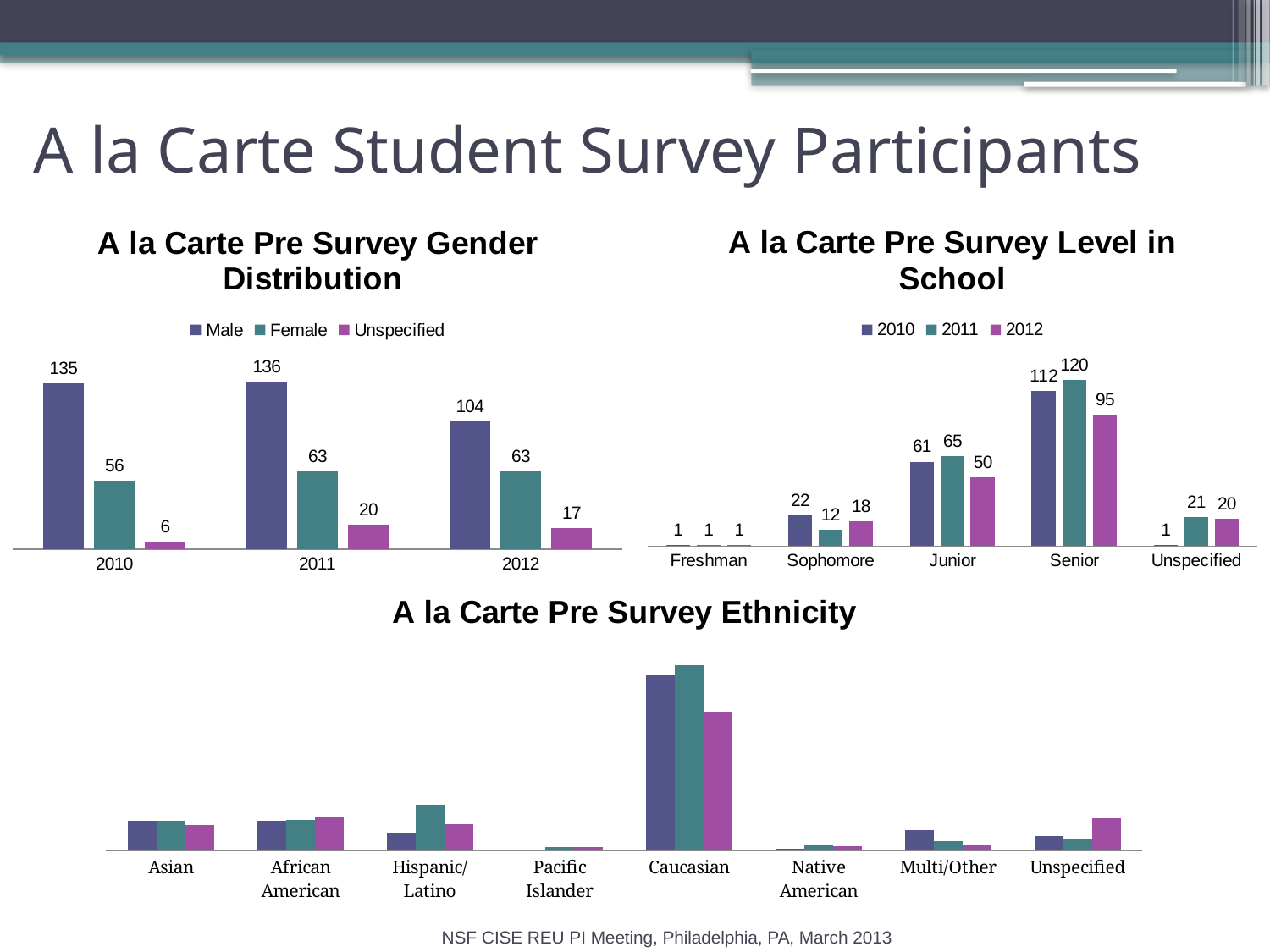
In the A la Carte Pre Survey Gender Distribution chart, what is the Male value for 2010? 135 In the A la Carte Pre Survey Level in School chart, what is the 2011 value for Senior? 120 In the A la Carte Pre Survey Ethnicity chart, which category has the tallest bars? Caucasian What kind of chart is the A la Carte Pre Survey Ethnicity chart? Bar chart In the A la Carte Pre Survey Gender Distribution chart, which year has the highest Male value? 2011 In the A la Carte Pre Survey Level in School chart, what is the 2012 value for Junior? 50 In the A la Carte Pre Survey Gender Distribution chart, what is the Unspecified value for 2011? 20 In the A la Carte Pre Survey Level in School chart, is the 2010 value for Sophomore larger or smaller than the 2012 value for Sophomore? larger How many categories are shown on the x axis of the A la Carte Pre Survey Level in School chart? 5 In the A la Carte Pre Survey Level in School chart, which level has the lowest values across all years? Freshman How many series does the legend of the A la Carte Pre Survey Gender Distribution chart list? 3 In the A la Carte Pre Survey Gender Distribution chart, what is the difference between the Male and Female values for 2012? 41